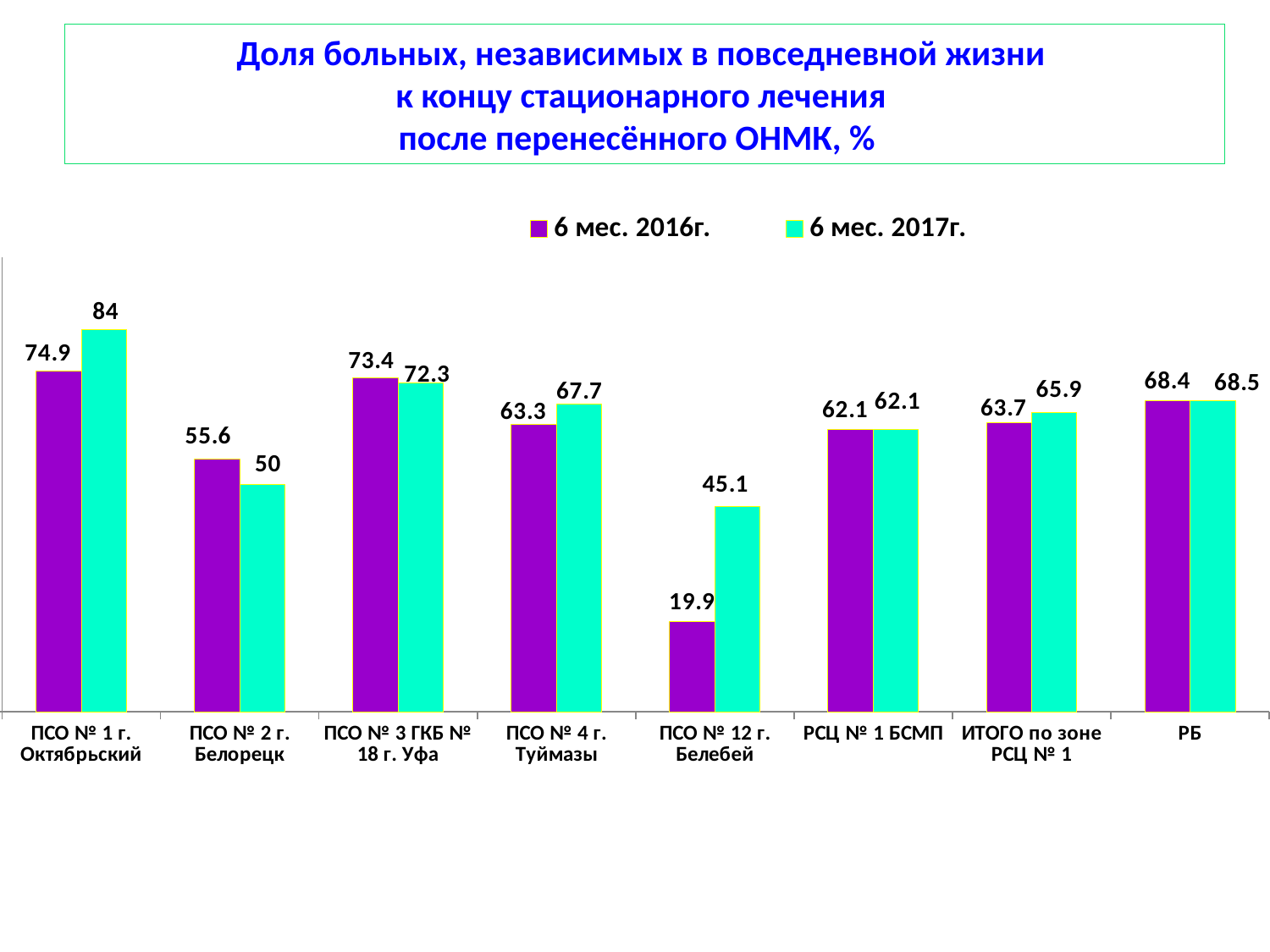
For ПСО № 3 ГКБ № 18 г. Уфа, which series has the larger value, 6 мес. 2016г. or 6 мес. 2017г.? 6 мес. 2016г. What is the difference between the 6 мес. 2017г. and 6 мес. 2016г. values for ПСО № 12 г. Белебей? 25.2 What is the value for РБ in the 6 мес. 2017г. series? 68.5 What is the value for ПСО № 1 г. Октябрьский in the 6 мес. 2017г. series? 84 What is the value for ПСО № 12 г. Белебей in the 6 мес. 2016г. series? 19.9 What kind of chart is shown on the slide? Bar chart What is the difference between the 6 мес. 2016г. and 6 мес. 2017г. values for ПСО № 2 г. Белорецк? 5.6 Which colour represents the 6 мес. 2017г. series? Cyan (turquoise) Which category has the highest value in the 6 мес. 2017г. series? ПСО № 1 г. Октябрьский How many categories are shown on the x axis? 8 How many series does the legend list? 2 Which category has the lowest value in the 6 мес. 2016г. series? ПСО № 12 г. Белебей